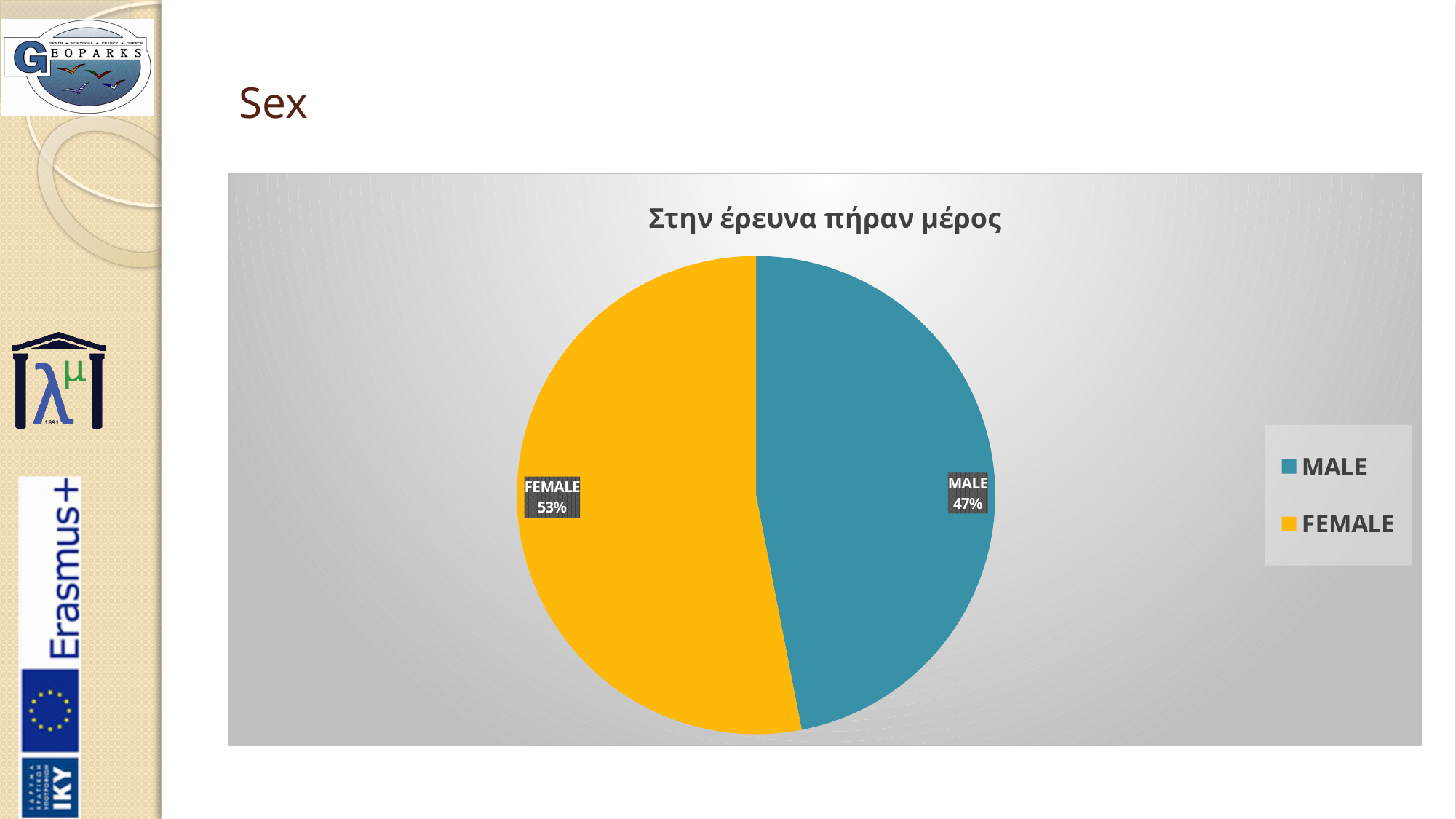
What colour is the FEMALE slice? yellow What is the difference in percentage points between the FEMALE and MALE shares? 6 What percentage of the pie is MALE? 47% Which category has the smallest share of the pie? MALE What is the share of the pie taken by the MALE slice? 47% Which category has the largest share of the pie? FEMALE What is the title of the chart? Στην έρευνα πήραν μέρος How many slices does the pie chart have? 2 Which share is larger, MALE or FEMALE? FEMALE How many entries does the legend list? 2 What percentage of the pie is FEMALE? 53% What type of chart is shown on the slide? pie chart